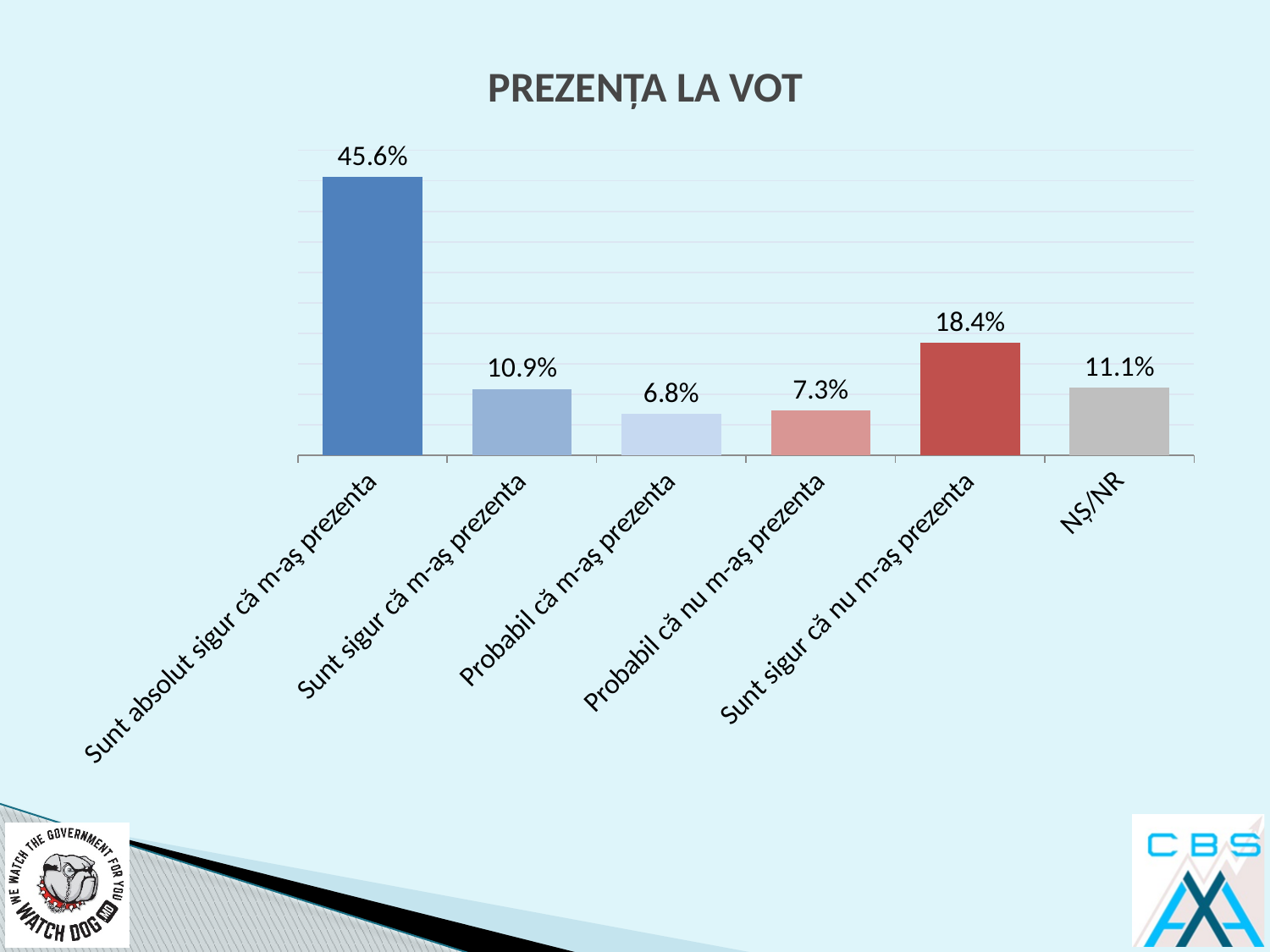
What is the value for "Sunt absolut sigur că m-aş prezenta"? 45.6% What is the value for "NŞ/NR"? 11.1% How many categories are shown in the chart? 6 What kind of chart is shown on the slide? Bar chart Which category has the highest value? Sunt absolut sigur că m-aş prezenta What is the value for "Probabil că nu m-aş prezenta"? 7.3% What is the difference between "Sunt sigur că m-aş prezenta" and "Probabil că m-aş prezenta"? 4.1% Which is larger, "Sunt sigur că m-aş prezenta" or "NŞ/NR"? NŞ/NR Which category has the lowest value? Probabil că m-aş prezenta What is the title of the chart? PREZENȚA LA VOT What is the difference between "Sunt absolut sigur că m-aş prezenta" and "Sunt sigur că nu m-aş prezenta"? 27.2% What is the value for "Sunt sigur că nu m-aş prezenta"? 18.4%